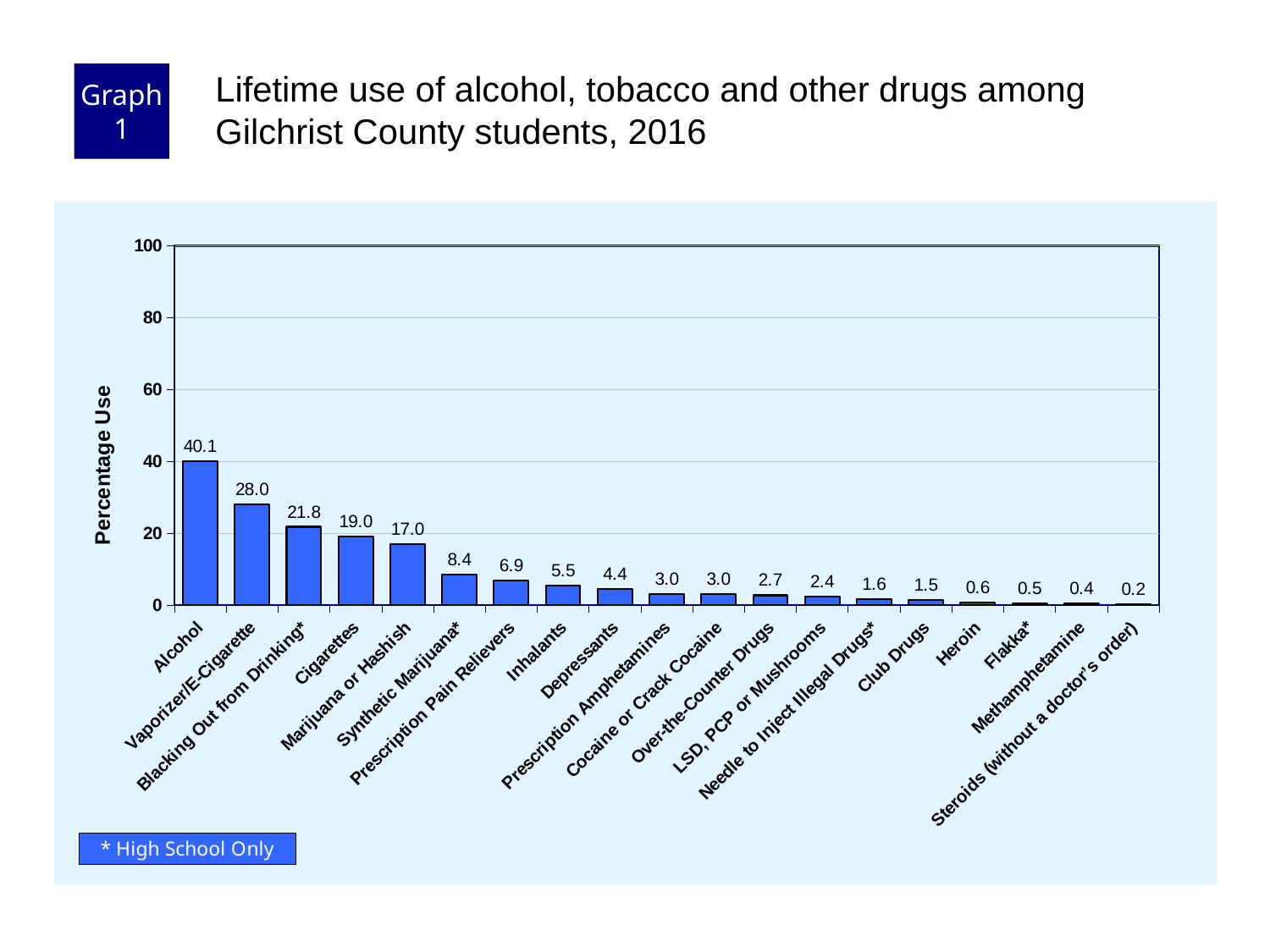
How many categories are shown on the chart? 19 Which has a higher percentage use, Marijuana or Hashish or Synthetic Marijuana*? Marijuana or Hashish What is the percentage use for Inhalants? 5.5 Do the values rise or fall from left to right along the x axis? Fall What kind of chart is shown on the slide? Bar chart Which category has the lowest percentage use? Steroids (without a doctor's order) What is the percentage use for Alcohol? 40.1 What is the percentage use for Cigarettes? 19.0 Is the value for Blacking Out from Drinking* greater or less than 20? greater What is the label of the y axis? Percentage Use Which category has the highest percentage use? Alcohol What is the difference in percentage use between Alcohol and Vaporizer/E-Cigarette? 12.1